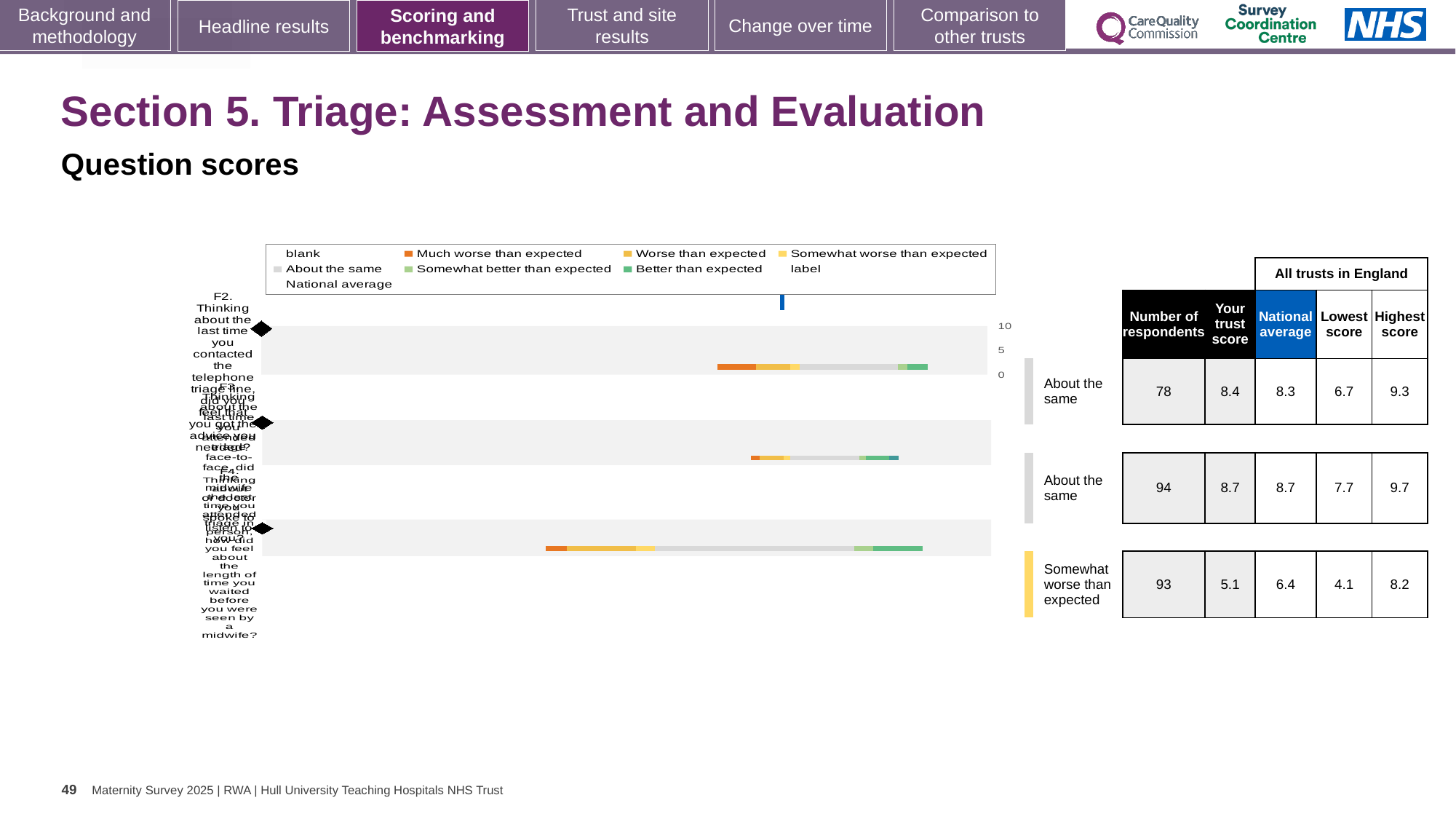
In the table beside the chart, what is the highest 'Your trust score' among the three rows? 8.7 What kind of chart is shown on the slide? bar chart In the table beside the chart, what is the number of respondents for the first row? 78 What colour does the chart legend use for 'Much worse than expected'? orange In the table beside the chart, what is the highest score for the second row? 9.7 In the table beside the chart, for the first row, which is larger: the trust score or the national average? trust score In the table beside the chart, what is the 'Your trust score' for the third row (Somewhat worse than expected)? 5.1 In the table beside the chart, what is the difference between the national average and the trust score for the third row (Somewhat worse than expected)? 1.3 How many question bars are plotted in the chart? 3 In the table beside the chart, what is the lowest score for the third row (Somewhat worse than expected)? 4.1